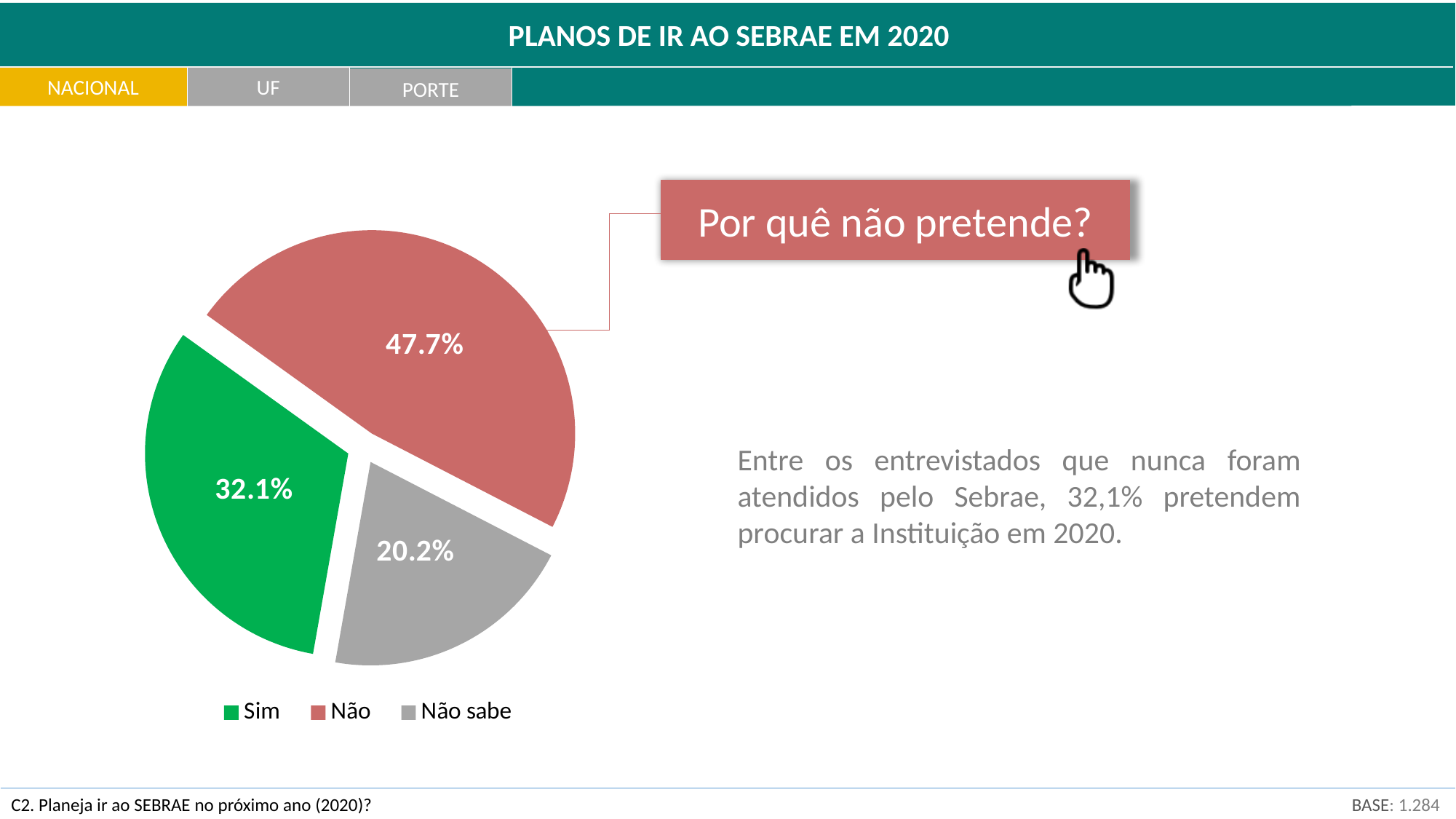
What is the difference in percentage points between "Sim" and "Não sabe"? 11.9 What is the title of the slide containing the pie chart? PLANOS DE IR AO SEBRAE EM 2020 Which category has the largest share of the pie? Não What percentage of respondents answered "Não sabe"? 20.2% What percentage of respondents answered "Sim"? 32.1% What is the difference in percentage points between "Não" and "Sim"? 15.6 Which category has the smallest share of the pie? Não sabe What percentage of respondents answered "Não"? 47.7% How many slices does the pie chart have? 3 Which is larger, the share for "Sim" or the share for "Não sabe"? Sim What type of chart is shown on the slide? Pie chart What colour is the "Sim" slice? Green